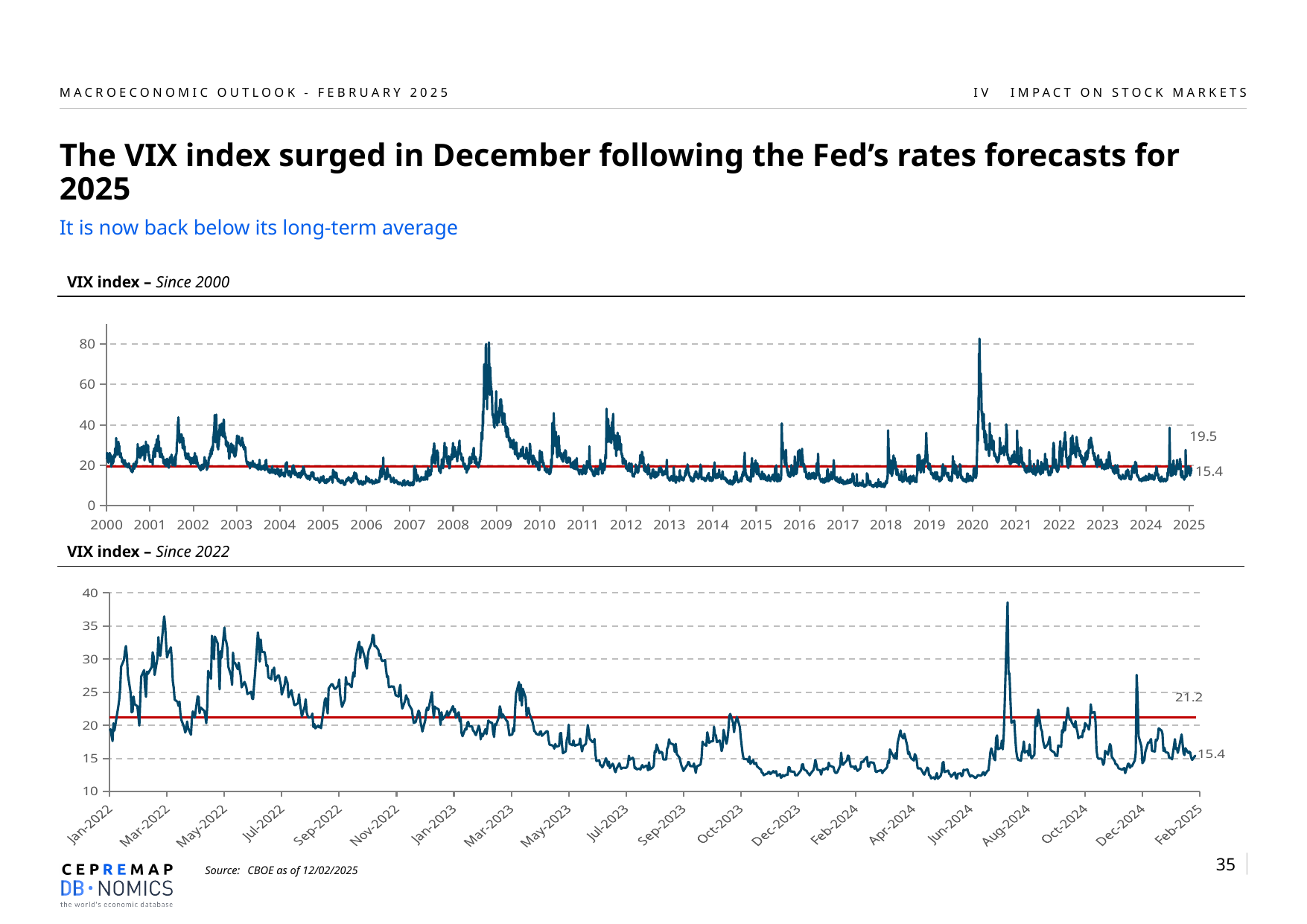
How many charts are shown on the slide? 2 In the 'VIX index – Since 2000' chart, what is the difference between the red line value (19.5) and the latest value (15.4)? 4.1 In the 'VIX index – Since 2022' chart, is the peak value reached in August 2024 greater or less than 35? greater In the 'VIX index – Since 2022' chart, is the latest value (15.4) larger or smaller than the red line value (21.2)? smaller In the 'VIX index – Since 2022' chart, what is the difference between the red line value (21.2) and the latest value (15.4)? 5.8 In the 'VIX index – Since 2000' chart, is the peak value reached in late 2008 greater or less than 60? greater In the 'VIX index – Since 2022' chart, what is the latest value labelled at the end of the line? 15.4 In the 'VIX index – Since 2000' chart, what value is labelled for the red horizontal line? 19.5 In the 'VIX index – Since 2000' chart, what is the latest value labelled at the end of the line? 15.4 What is the title of the lower chart on the slide? VIX index – Since 2022 What type of chart is the 'VIX index – Since 2000' chart? line chart In the 'VIX index – Since 2022' chart, what value is labelled for the red horizontal line? 21.2